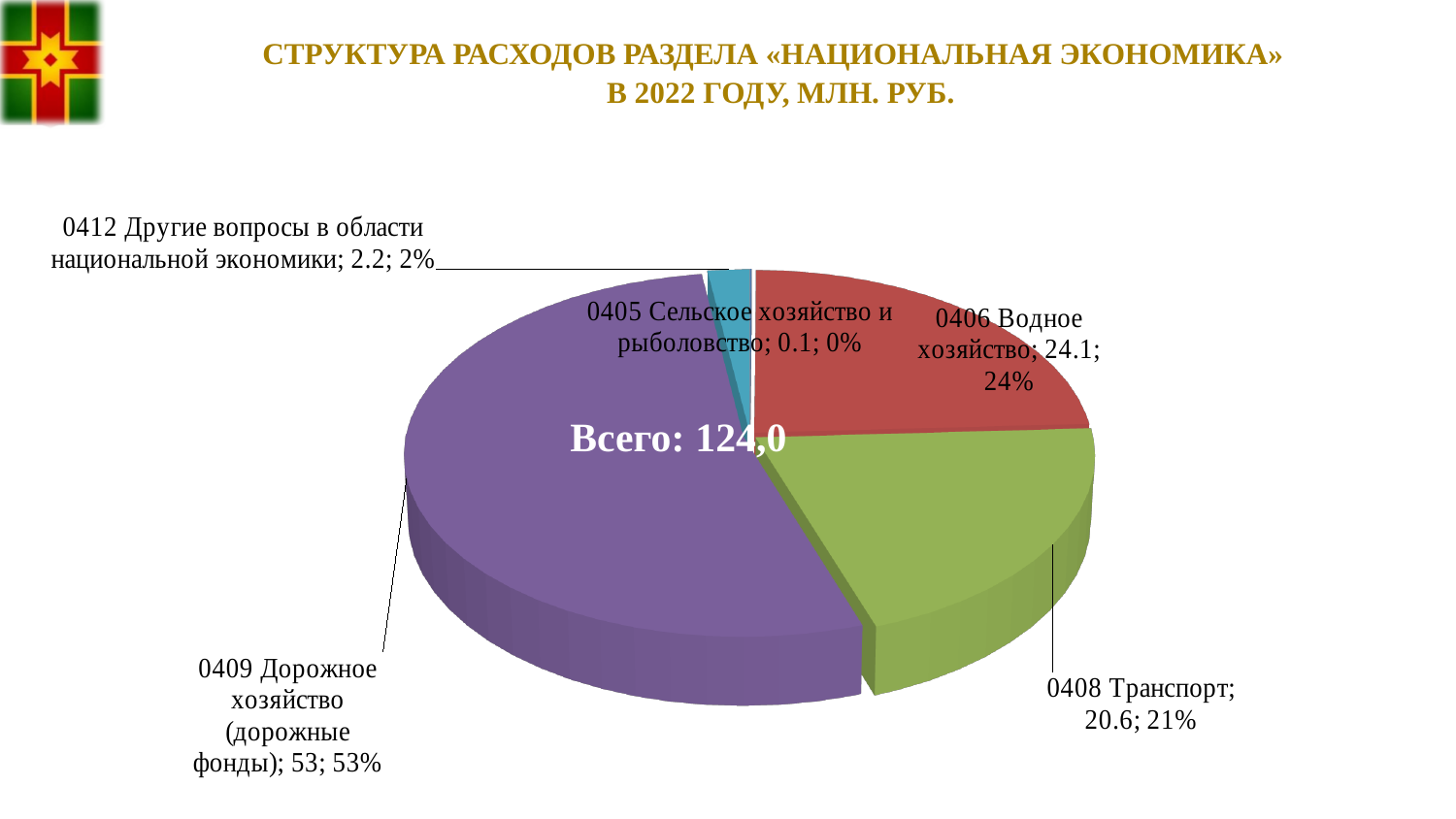
How many slices does the pie chart have? 5 What share of the pie does 0408 Транспорт represent? 21% What is the value for 0408 Транспорт? 20.6 Which is larger, the value for 0406 Водное хозяйство or the value for 0408 Транспорт? 0406 Водное хозяйство What kind of chart is shown on the slide? Pie chart Which category has the largest slice of the pie? 0409 Дорожное хозяйство (дорожные фонды) What is the value for 0412 Другие вопросы в области национальной экономики? 2.2 What is the difference between the values for 0406 Водное хозяйство and 0408 Транспорт? 3.5 Which category has the smallest slice of the pie? 0405 Сельское хозяйство и рыболовство What is the value for 0406 Водное хозяйство? 24.1 What is the value for 0409 Дорожное хозяйство (дорожные фонды)? 53 What is the value for 0405 Сельское хозяйство и рыболовство? 0.1